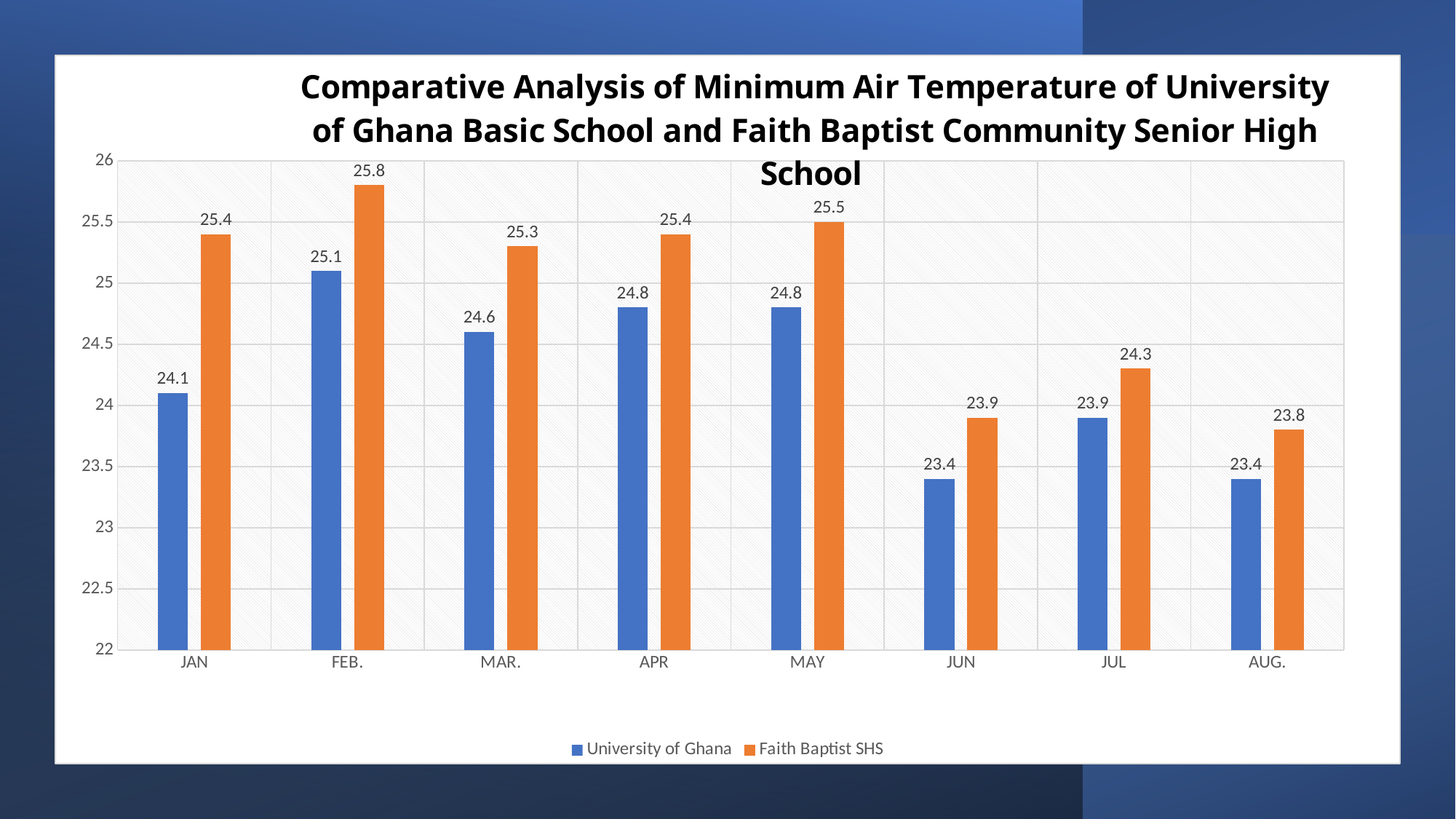
What is the value for Faith Baptist SHS in JUL? 24.3 What is the difference between the University of Ghana values in FEB. and JUN? 1.7 What is the minimum air temperature for Faith Baptist SHS in FEB.? 25.8 In which month is the Faith Baptist SHS value highest? FEB. Which is larger in MAY: the University of Ghana value or the Faith Baptist SHS value? Faith Baptist SHS What kind of chart is shown on the slide? Bar chart How many series does the legend list? 2 Which colour represents Faith Baptist SHS in the chart? Orange How many months are shown on the x axis? 8 What is the difference between the Faith Baptist SHS and University of Ghana values in JAN? 1.3 What is the minimum air temperature for University of Ghana in JAN? 24.1 In which month is the University of Ghana value highest? FEB.